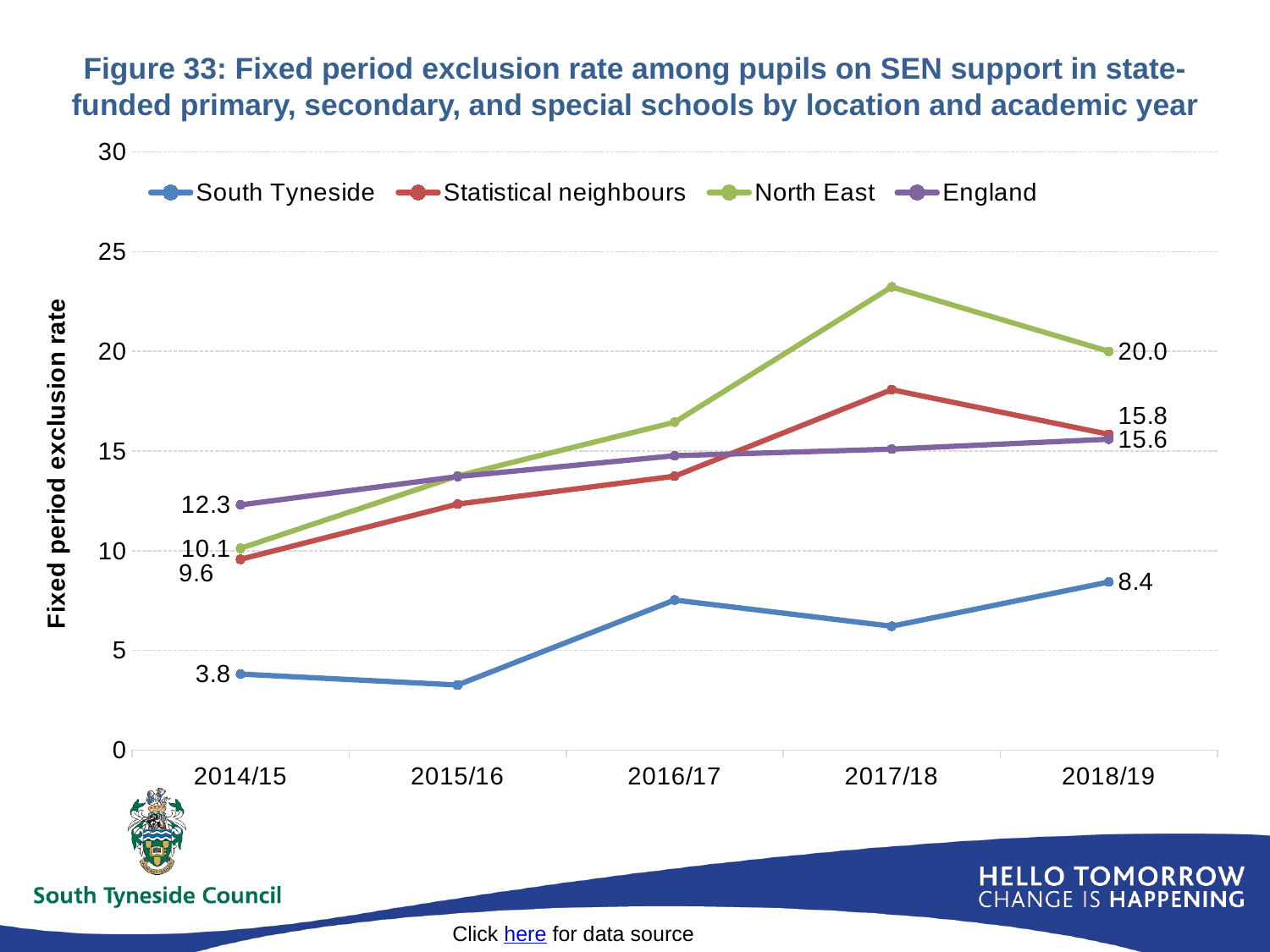
What kind of chart is shown on the slide? line chart Is the value for the North East in 2017/18 greater or less than 20? greater Does the North East line rise or fall from 2014/15 to 2017/18? rise How many academic years are shown on the x axis? 5 Which location has the highest fixed period exclusion rate in 2018/19? North East How many series does the legend list? 4 By how much did South Tyneside's fixed period exclusion rate increase from 2014/15 to 2018/19? 4.6 What is the fixed period exclusion rate for South Tyneside in 2014/15? 3.8 What is the fixed period exclusion rate for South Tyneside in 2018/19? 8.4 What is the fixed period exclusion rate for the North East in 2018/19? 20.0 Which location has the lowest fixed period exclusion rate in 2014/15? South Tyneside What is the fixed period exclusion rate for England in 2014/15? 12.3